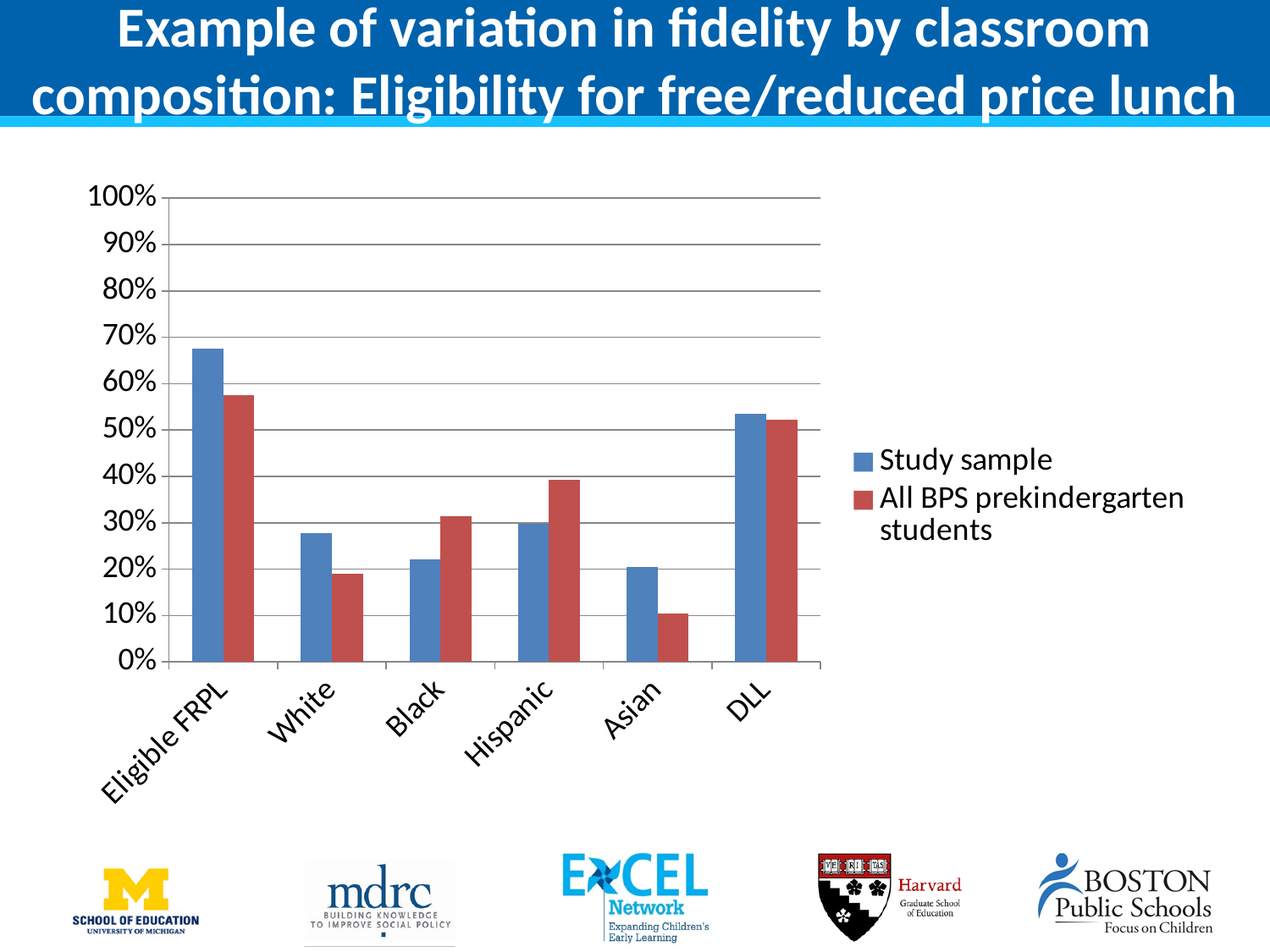
Which category has the lowest value for the All BPS prekindergarten students series? Asian How many categories are shown along the x axis of the chart? 6 How many series does the chart's legend list? 2 Which category has the highest value for the Study sample series? Eligible FRPL Is the Study sample value for Eligible FRPL greater or less than 60%? greater Is the Study sample value for White greater or less than 30%? less For the Black category, which series has the larger value: Study sample or All BPS prekindergarten students? All BPS prekindergarten students Is the All BPS prekindergarten students value for Hispanic greater or less than 30%? greater For the Asian category, which series has the larger value: Study sample or All BPS prekindergarten students? Study sample What are the two series named in the chart's legend? Study sample; All BPS prekindergarten students What kind of chart is shown on the slide? bar chart